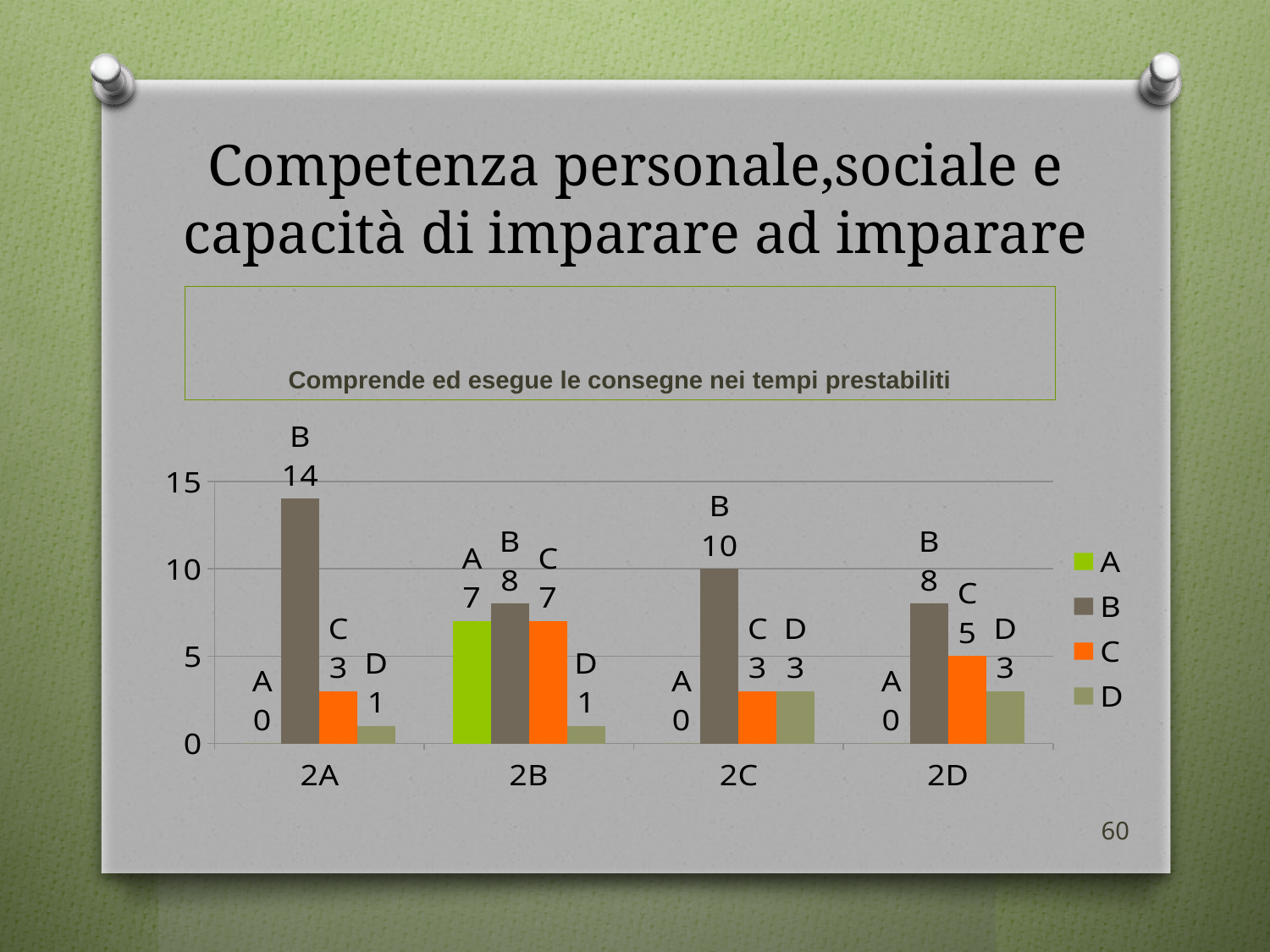
What is the value of series D for category 2C? 3 How many series does the legend list? 4 What kind of chart is shown on the slide? bar chart What is the value of series B for category 2A? 14 How many categories are shown on the x axis? 4 Which category has the lowest value for series B? 2B and 2D What is the value of series C for category 2D? 5 Which category has the highest value for series B? 2A Which is larger: the C value for 2B or the C value for 2D? 2B What is the value of series A for category 2B? 7 What is the difference between the B value for 2A and the B value for 2C? 4 What is the title of the chart? Comprende ed esegue le consegne nei tempi prestabiliti